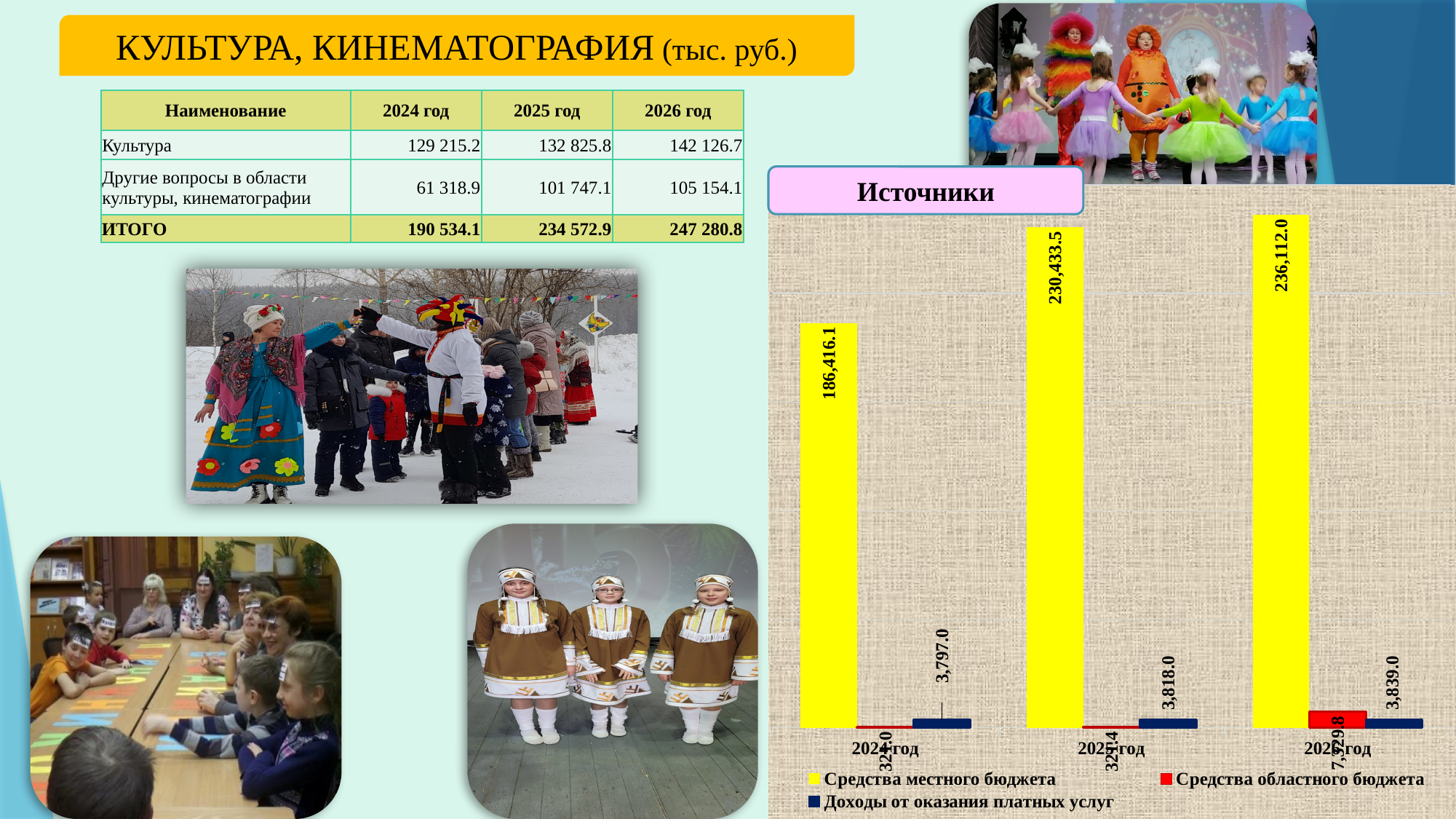
In the "Источники" chart, what is the value of Средства местного бюджета for 2025 год? 230,433.5 In the "Источники" chart, what is the value of Средства местного бюджета for 2026 год? 236,112.0 How many series does the legend of the "Источники" chart list? 3 In the "Источники" chart, does Средства местного бюджета rise or fall from 2024 год to 2026 год? rise In the "Источники" chart, which year has the highest value for Средства местного бюджета? 2026 год In the "Источники" chart, what is the value of Доходы от оказания платных услуг for 2024 год? 3,797.0 In the "Источники" chart, what is the value of Средства местного бюджета for 2024 год? 186,416.1 In the "Источники" chart, which year has the lowest value for Средства местного бюджета? 2024 год In the "Источники" chart, what is the value of Доходы от оказания платных услуг for 2026 год? 3,839.0 In the "Источники" chart, what is the difference between Средства местного бюджета in 2025 год and 2024 год? 44,017.4 What kind of chart is shown under the title "Источники"? bar chart In the "Источники" chart, which colour represents Средства областного бюджета? red